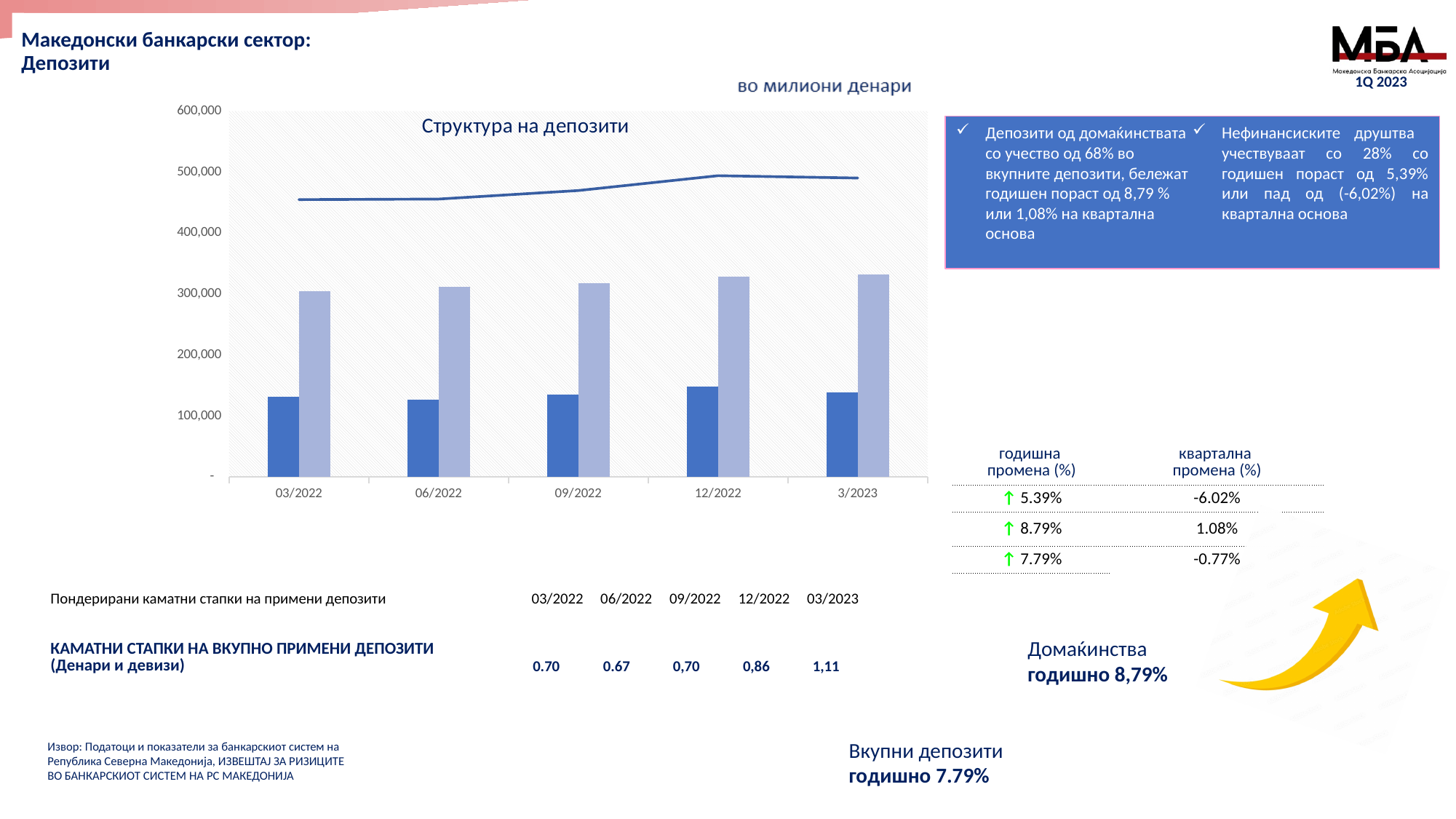
What unit is stated above the 'Структура на депозити' chart? во милиони денари In the 'Структура на депозити' chart, do the light blue bars rise or fall from 03/2022 to 3/2023? Rise In the 'Структура на депозити' chart, is the dark blue bar for 12/2022 greater or less than 200,000? less In the 'Структура на депозити' chart, is the light blue bar for 03/2022 greater or less than 200,000? greater In the 'Структура на депозити' chart, is the light blue bar for 3/2023 greater or less than 400,000? less What kind of chart is 'Структура на депозити'? A combined bar and line chart In the 'Структура на депозити' chart, which bar is taller for 03/2022, the dark blue bar or the light blue bar? The light blue bar What is the title of the chart on the slide? Структура на депозити How many time periods are shown on the x axis of the 'Структура на депозити' chart? 5